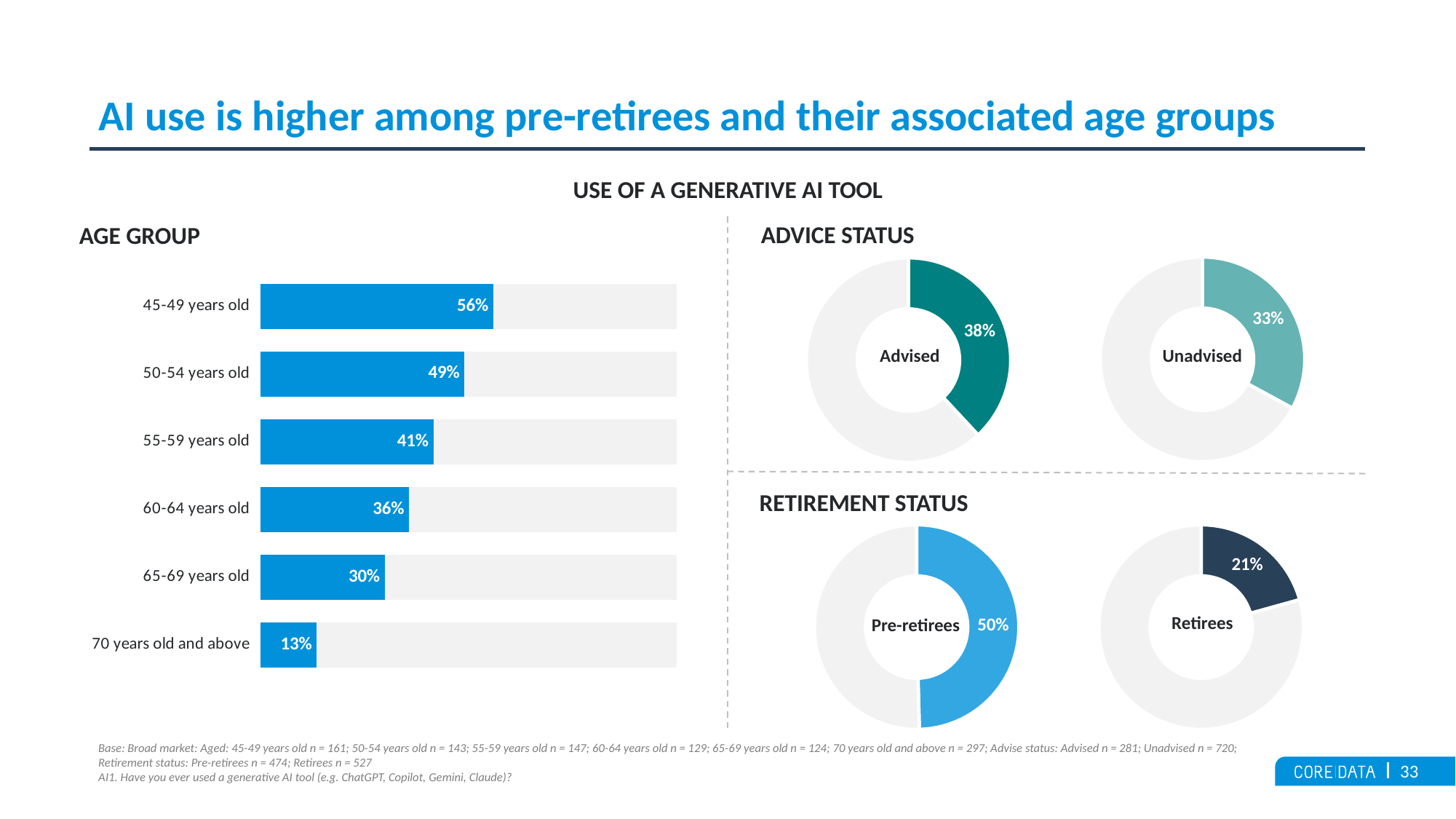
In the Advice Status donut charts, what is the value for Advised? 38% In the Retirement Status donut charts, what is the difference between Pre-retirees and Retirees? 29% In the Age Group bar chart, what is the value for 60-64 years old? 36% What is the overall title above the charts on the slide? USE OF A GENERATIVE AI TOOL In the Advice Status donut charts, which is larger, Advised or Unadvised? Advised In the Age Group bar chart, which age group has the highest value? 45-49 years old In the Age Group bar chart, how many age groups are shown? 6 In the Age Group bar chart, what is the value for 45-49 years old? 56% In the Age Group bar chart, which age group has the lowest value? 70 years old and above In the Age Group bar chart, what is the difference between the values for 50-54 years old and 65-69 years old? 19% What kind of chart is the Age Group chart? bar chart In the Age Group bar chart, do the values rise or fall as age increases from 45-49 to 70 and above? fall